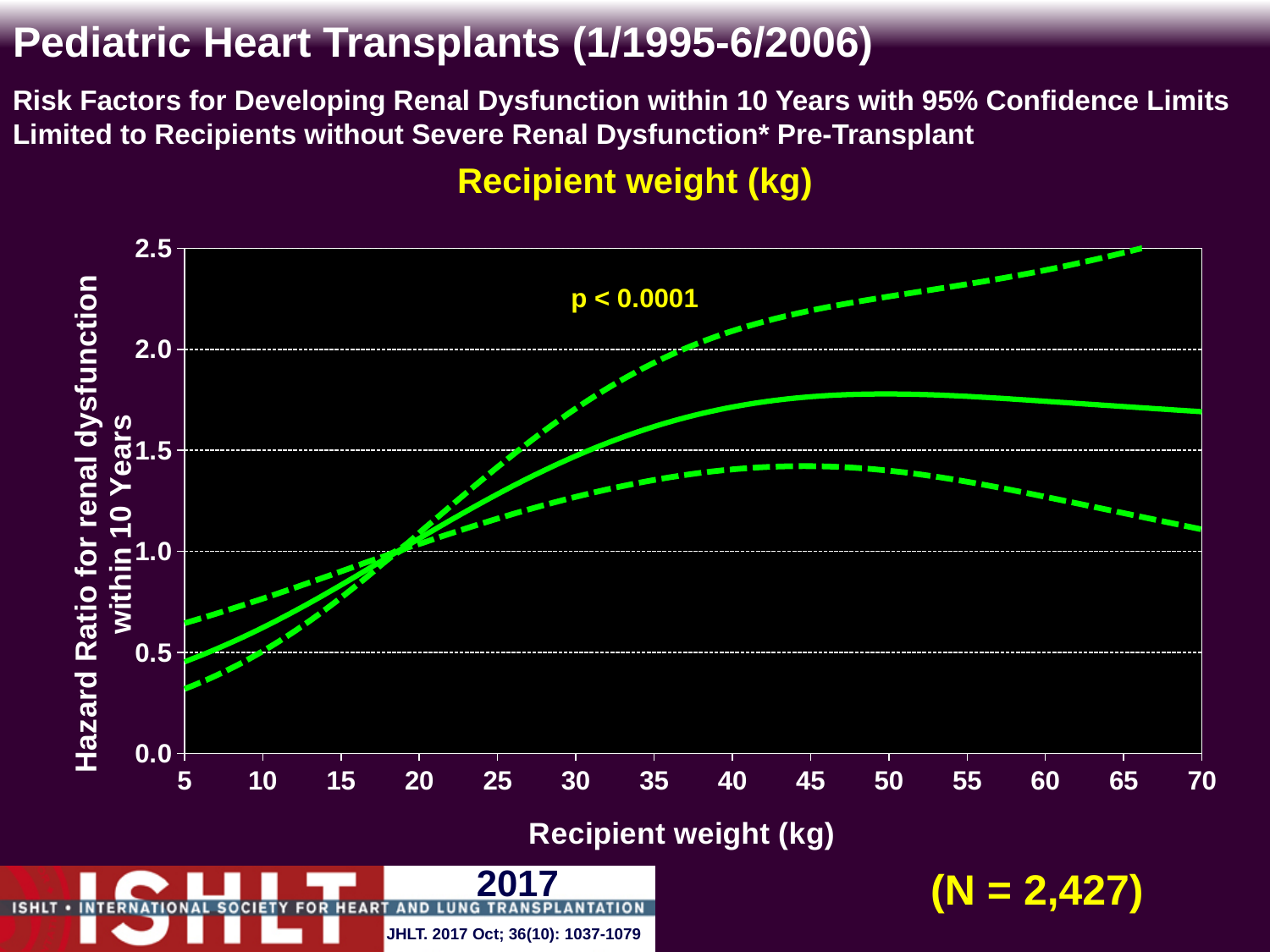
How many tick labels are shown on the x axis? 14 Does the solid hazard ratio line rise or fall between 5 kg and 40 kg? Rise Is the solid hazard ratio line at 40 kg greater or less than 1.5? greater Is the solid hazard ratio line at 70 kg greater or less than 1.5? greater What is the label of the x axis? Recipient weight (kg) What is the p-value printed on the chart? p < 0.0001 Is the lower dashed confidence limit at 5 kg greater or less than 0.5? less Which has the higher hazard ratio on the solid line, 5 kg or 70 kg? 70 kg What kind of chart is shown on the slide? Line chart How many lines are plotted on the chart? 3